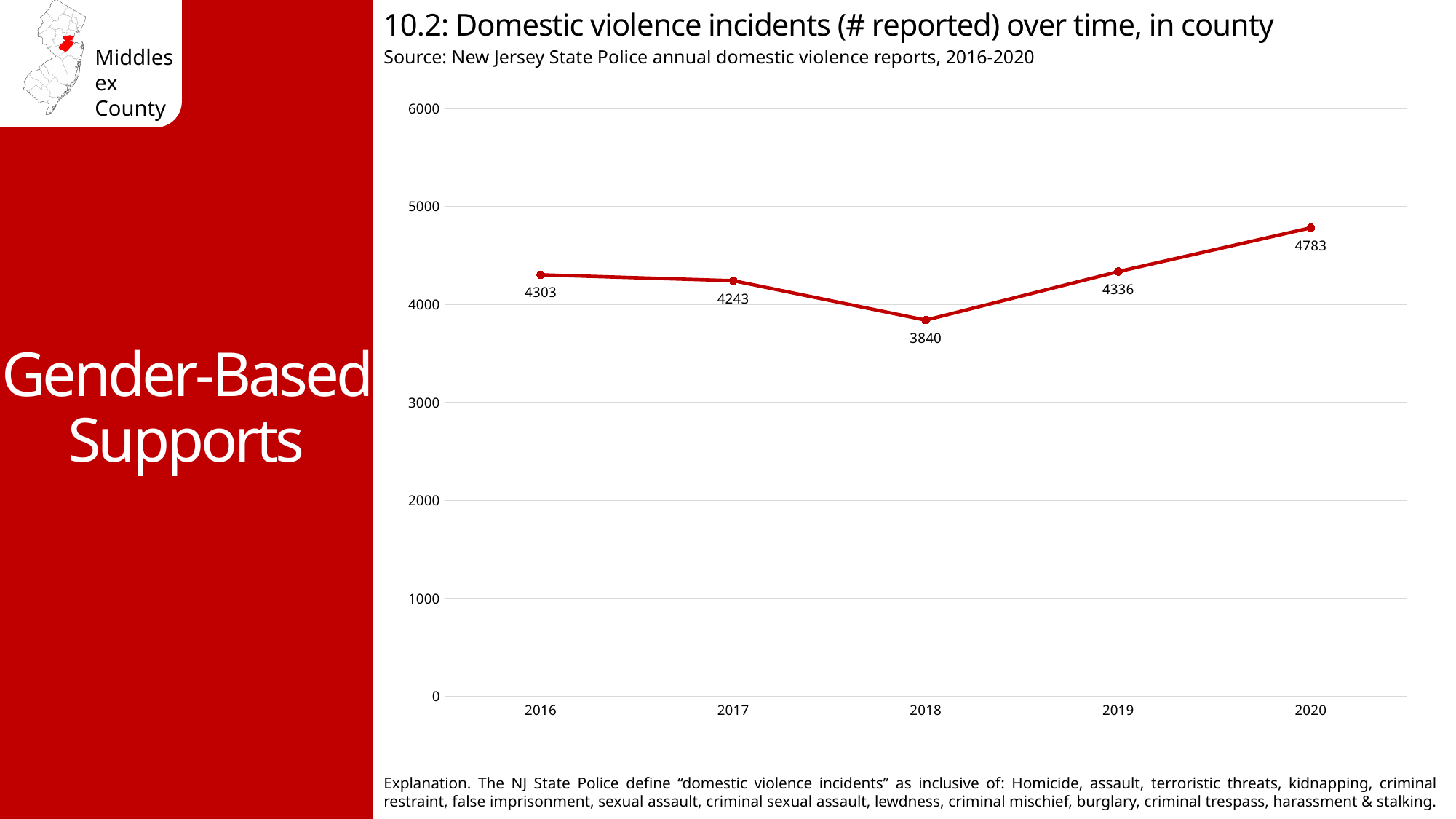
What type of chart is shown on the slide? line chart What is the value plotted for 2020? 4783 What is the difference between the 2016 value and the 2017 value? 60 How many reported domestic violence incidents were there in 2018? 3840 Which year has the lowest number of reported domestic violence incidents? 2018 Which year has a larger value, 2019 or 2017? 2019 How many years are plotted on the x axis? 5 Which year has the highest number of reported domestic violence incidents? 2020 What is the difference between the 2020 value and the 2018 value? 943 Is the value for 2018 greater or less than 4000? less Do the values rise or fall from 2018 to 2020? rise What is the value plotted for 2016? 4303